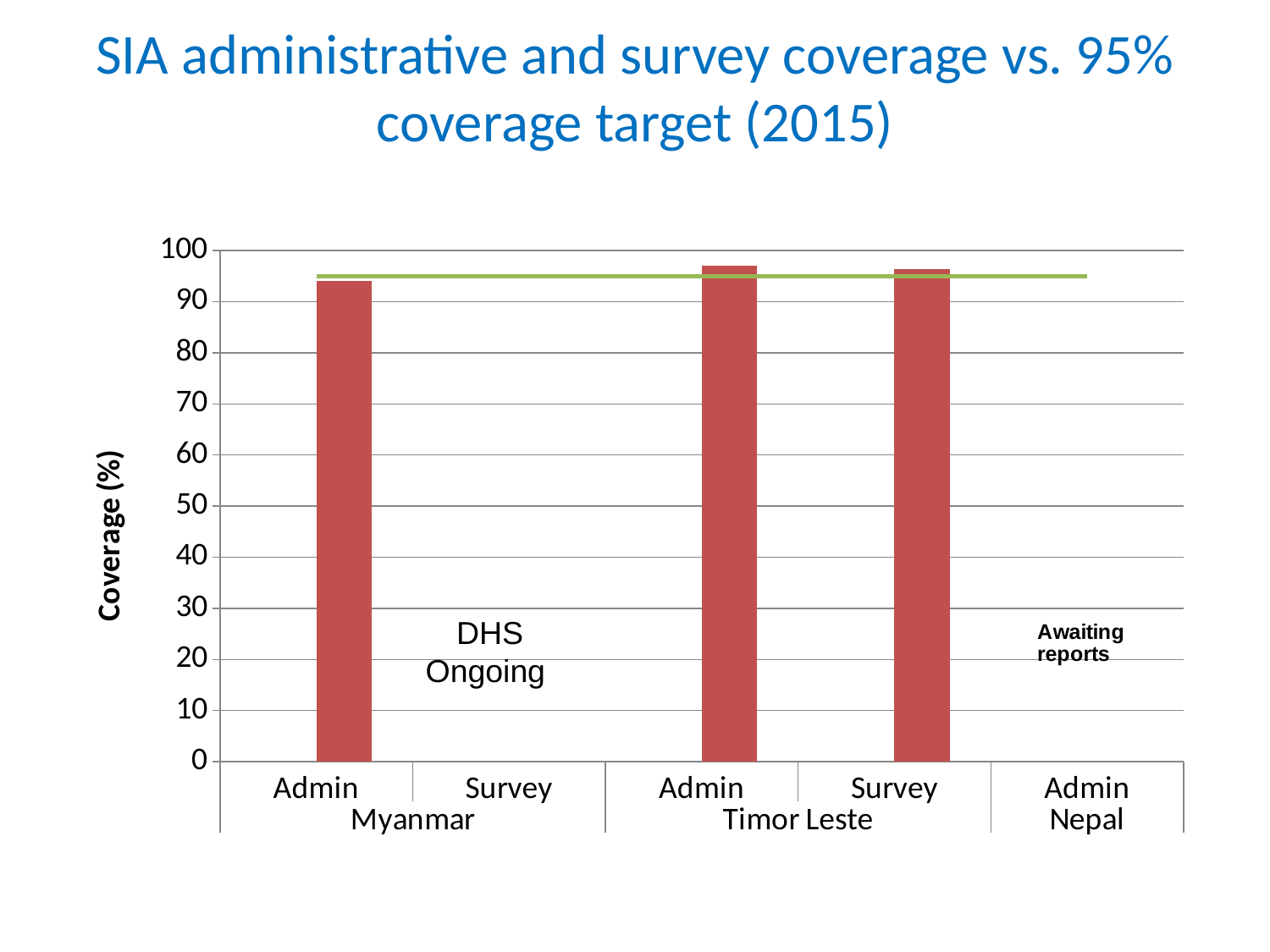
How many bars are plotted in the chart? 3 How many countries are shown along the x axis? 3 Is the value for Timor Leste Admin greater or less than 95? greater Which is larger, the Admin coverage for Myanmar or the Admin coverage for Timor Leste? Timor Leste Admin Is the value for Timor Leste Survey greater or less than 90? greater What is the title of the chart on the slide? SIA administrative and survey coverage vs. 95% coverage target (2015) What is the label of the vertical axis? Coverage (%) What kind of chart is shown on the slide? bar chart Is the value for Myanmar Admin greater or less than 90? greater Why is there no bar for Nepal Admin? Awaiting reports Which plotted bar has the lowest coverage? Myanmar Admin